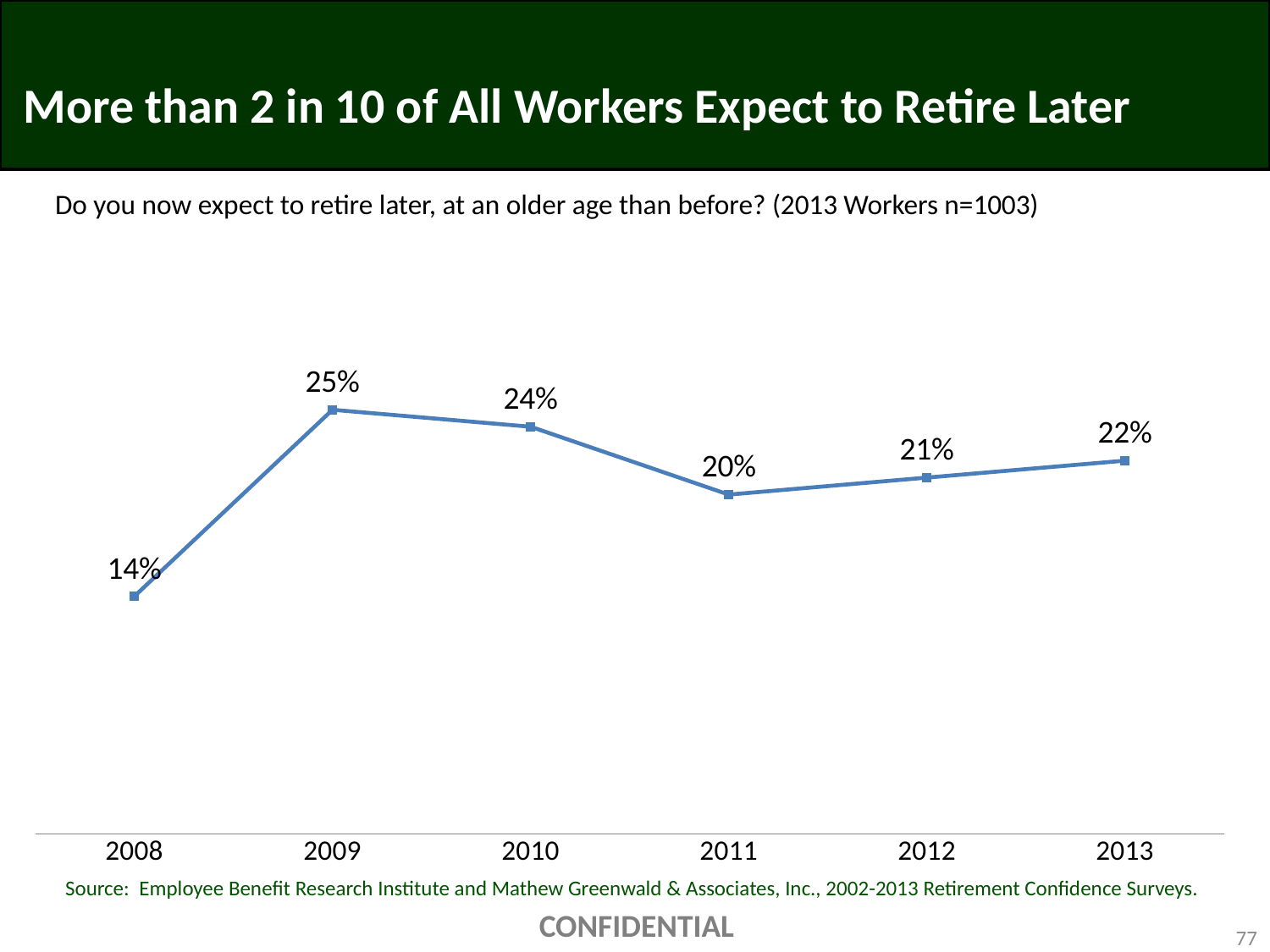
What is the value shown for 2013? 22% Which year has the lowest value on the chart? 2008 What percentage of workers expected to retire later in 2008? 14% What is the value shown for 2011? 20% What kind of chart is shown on the slide? Line chart What is the title of the slide? More than 2 in 10 of All Workers Expect to Retire Later Which year has the highest value on the chart? 2009 What is the difference between the 2009 value and the 2008 value? 11% What is the difference between the 2010 value and the 2011 value? 4% Did the value rise or fall from 2011 to 2013? Rise How many years are plotted on the chart? 6 Which year has a higher value, 2010 or 2012? 2010